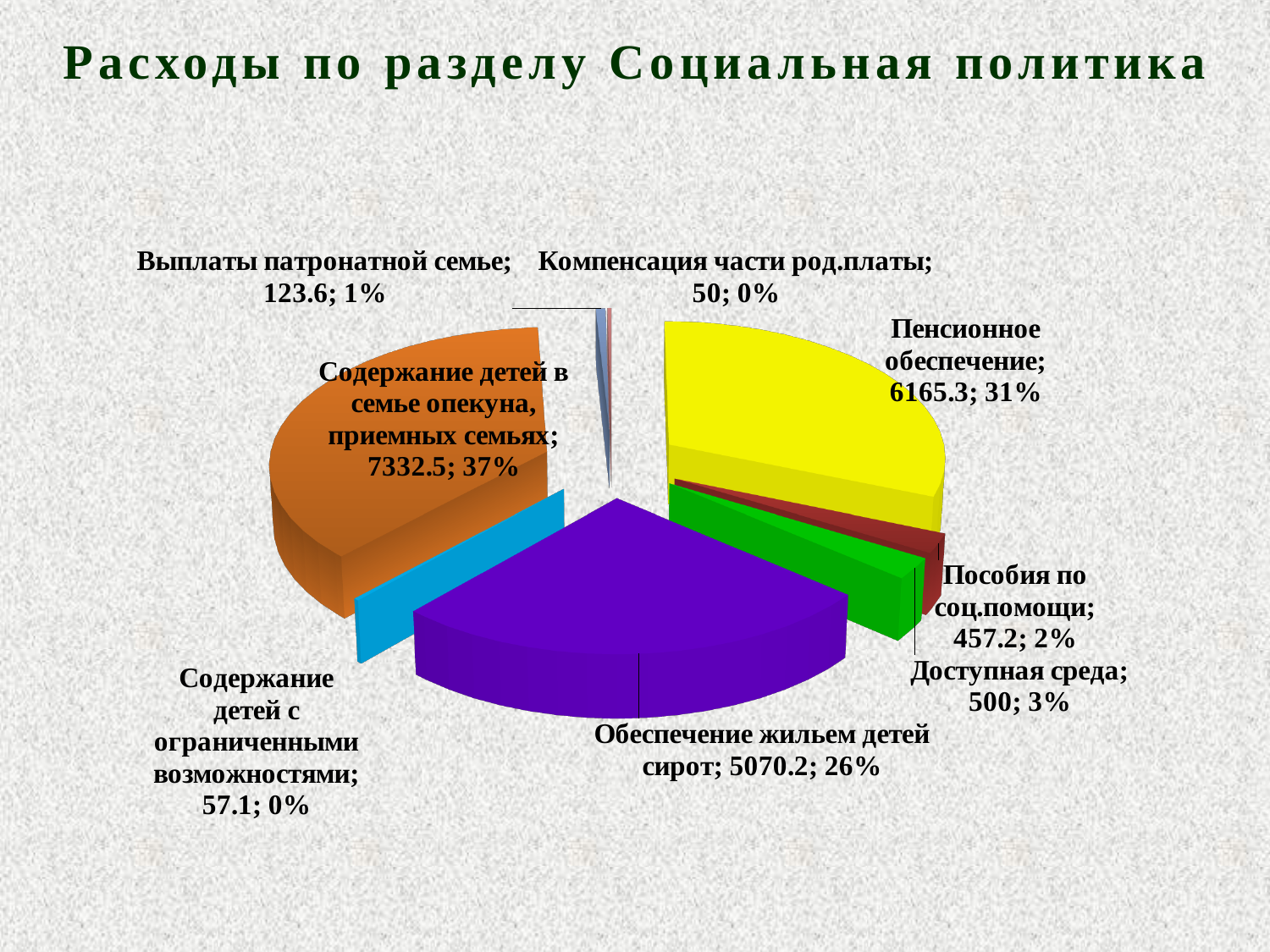
What share of the pie does Содержание детей в семье опекуна, приемных семьях represent? 37% Which category has the largest value? Содержание детей в семье опекуна, приемных семьях Which category has the smallest value? Компенсация части род.платы Which is larger: the value for Выплаты патронатной семье or the value for Содержание детей с ограниченными возможностями? Выплаты патронатной семье What is the difference between the values for Пенсионное обеспечение and Обеспечение жильем детей сирот? 1095.1 What is the title of the chart? Расходы по разделу Социальная политика What is the value for Пенсионное обеспечение? 6165.3 What kind of chart is shown on the slide? Pie chart How many categories (slices) does the pie chart have? 8 What is the value for Обеспечение жильем детей сирот? 5070.2 What share of the pie does Пособия по соц.помощи represent? 2% What is the value for Доступная среда? 500